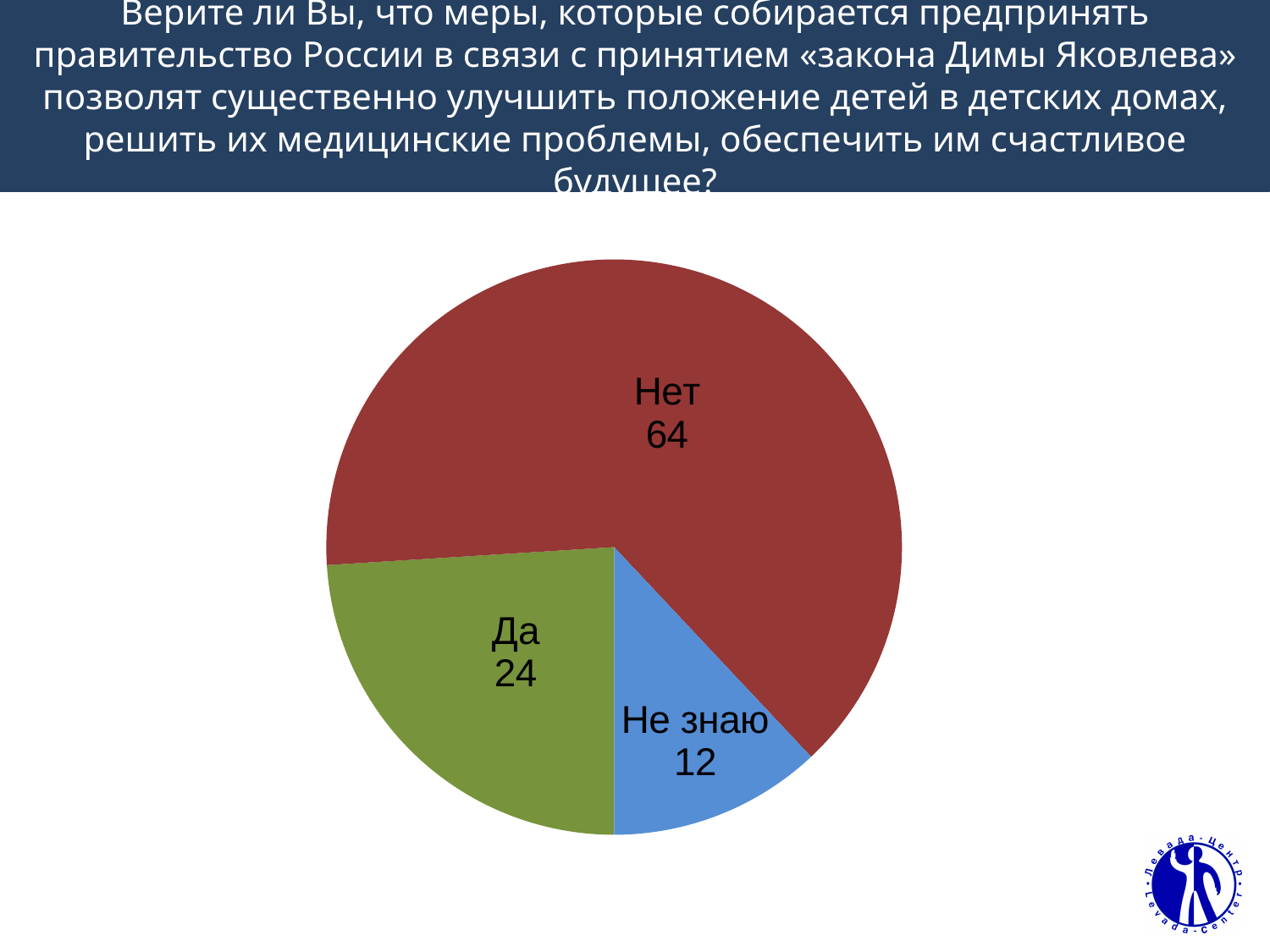
What value is shown for the "Нет" slice? 64 Which slice has the smallest value? Не знаю What is the difference between the values for "Да" and "Не знаю"? 12 Which is larger, the value for "Да" or the value for "Не знаю"? Да What colour is the "Нет" slice? Red What value is shown for the "Да" slice? 24 What is the total of all the slice values shown? 100 What kind of chart is shown on the slide? Pie chart Which slice has the largest value? Нет What is the difference between the values for "Нет" and "Да"? 40 How many slices does the pie chart have? 3 What value is shown for the "Не знаю" slice? 12